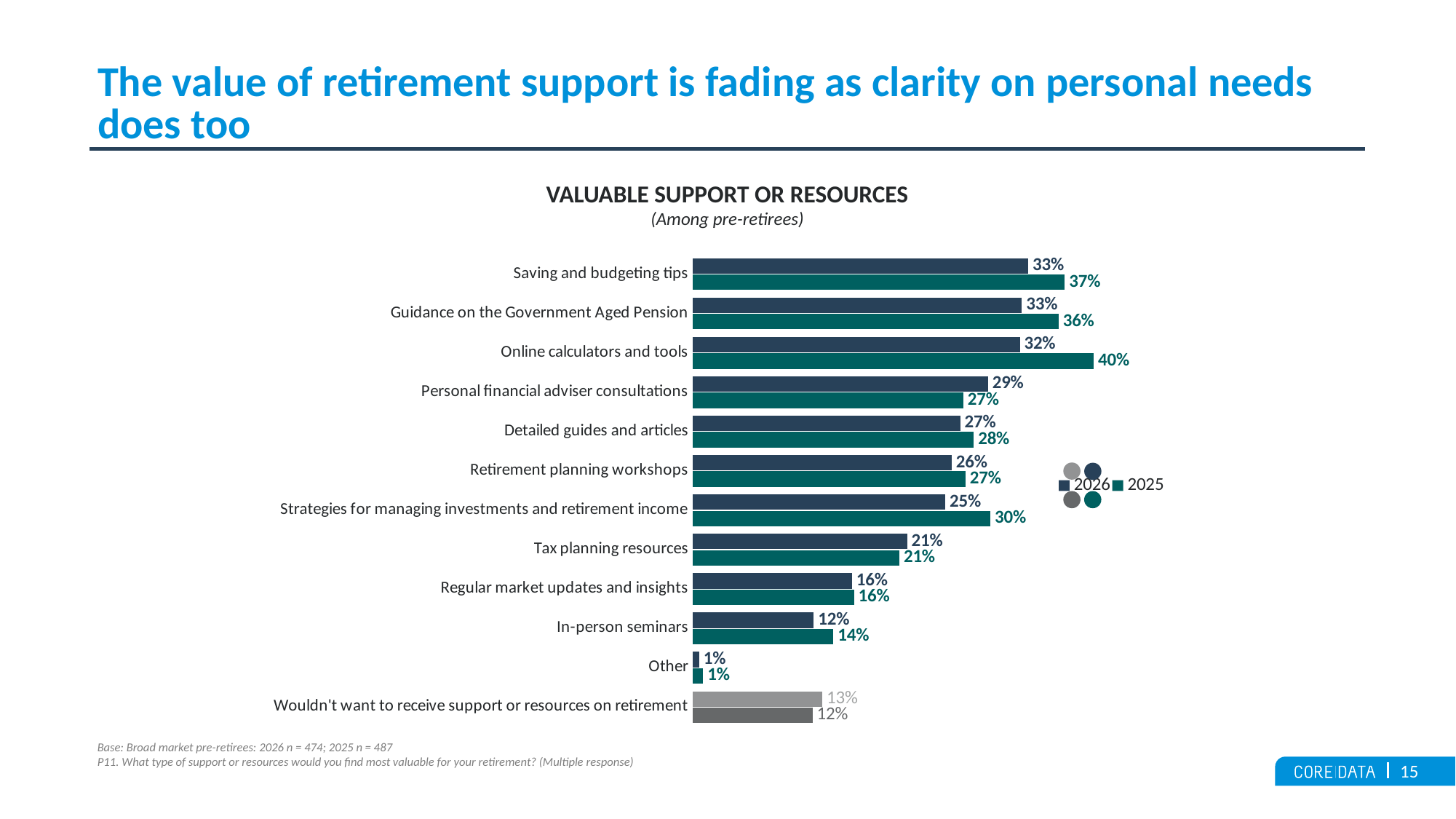
What is the 2025 value for Online calculators and tools? 40% For In-person seminars, which year has the larger value, 2026 or 2025? 2025 What is the 2026 value for Saving and budgeting tips? 33% How many categories are shown on the chart? 12 What is the 2026 value for Strategies for managing investments and retirement income? 25% How many series does the legend list? 2 What is the title of the chart? VALUABLE SUPPORT OR RESOURCES Which category has the lowest 2026 value? Other What is the difference between the 2025 and 2026 values for Online calculators and tools? 8% What is the difference between the 2026 and 2025 values for Personal financial adviser consultations? 2% What kind of chart is shown on the slide? Bar chart Which category has the highest 2025 value? Online calculators and tools